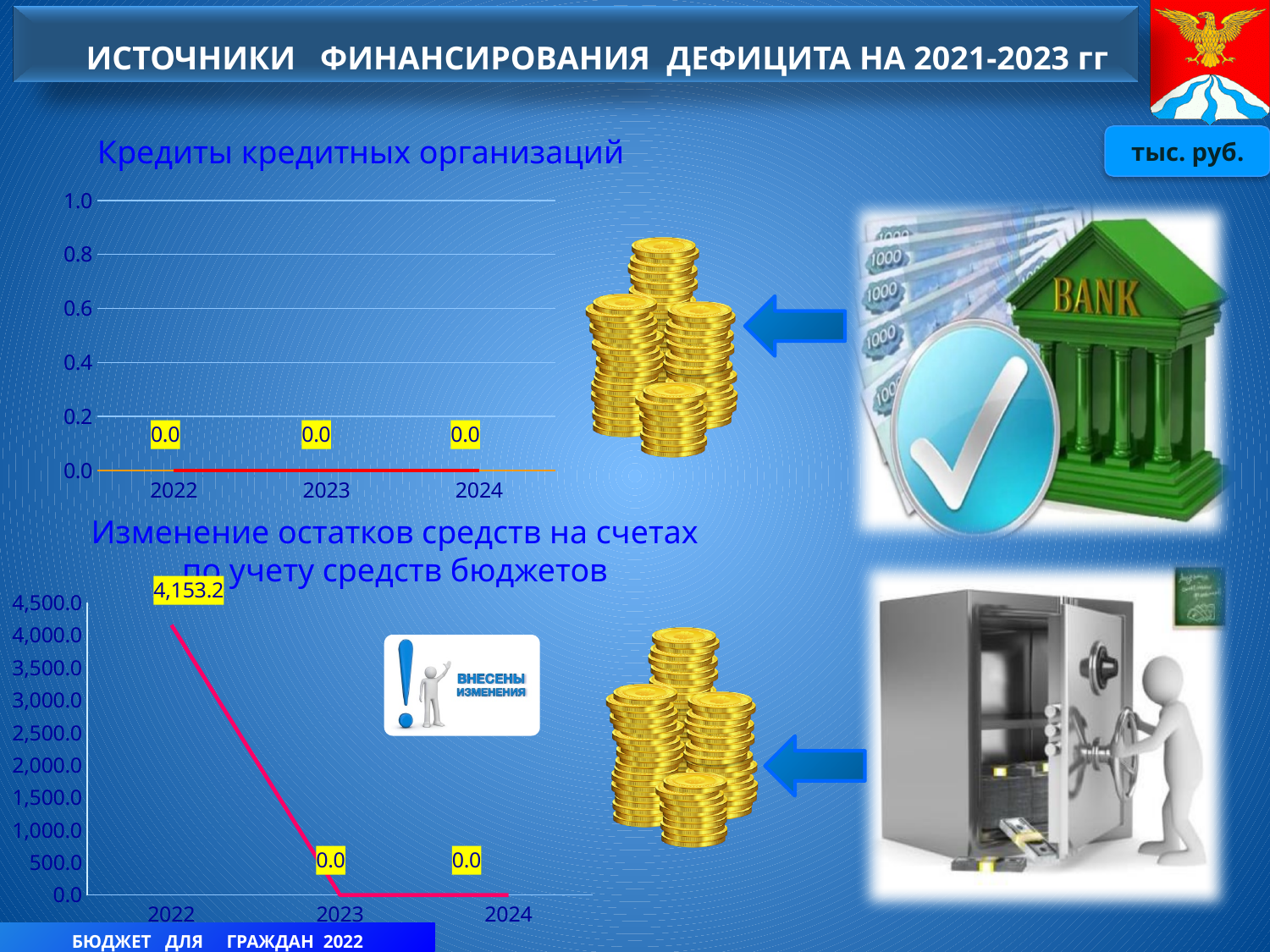
In the chart titled "Кредиты кредитных организаций", what is the value for 2024? 0.0 In the chart titled "Изменение остатков средств на счетах по учету средств бюджетов", what is the difference between the 2022 value and the 2023 value? 4,153.2 What kind of chart is the chart titled "Кредиты кредитных организаций"? line chart In the chart titled "Изменение остатков средств на счетах по учету средств бюджетов", what is the value for 2023? 0.0 In the chart titled "Изменение остатков средств на счетах по учету средств бюджетов", is the value for 2022 greater or less than 4,000.0? greater In the chart titled "Изменение остатков средств на счетах по учету средств бюджетов", what is the value for 2022? 4,153.2 In the chart titled "Кредиты кредитных организаций", how many years are plotted on the x axis? 3 What unit of measurement is indicated on the slide for the charts? тыс. руб. In the chart titled "Изменение остатков средств на счетах по учету средств бюджетов", do the values rise or fall from 2022 to 2024? fall In the chart titled "Кредиты кредитных организаций", what is the value for 2022? 0.0 In the chart titled "Изменение остатков средств на счетах по учету средств бюджетов", which is larger, the value for 2022 or the value for 2024? 2022 In the chart titled "Изменение остатков средств на счетах по учету средств бюджетов", which year has the highest value? 2022